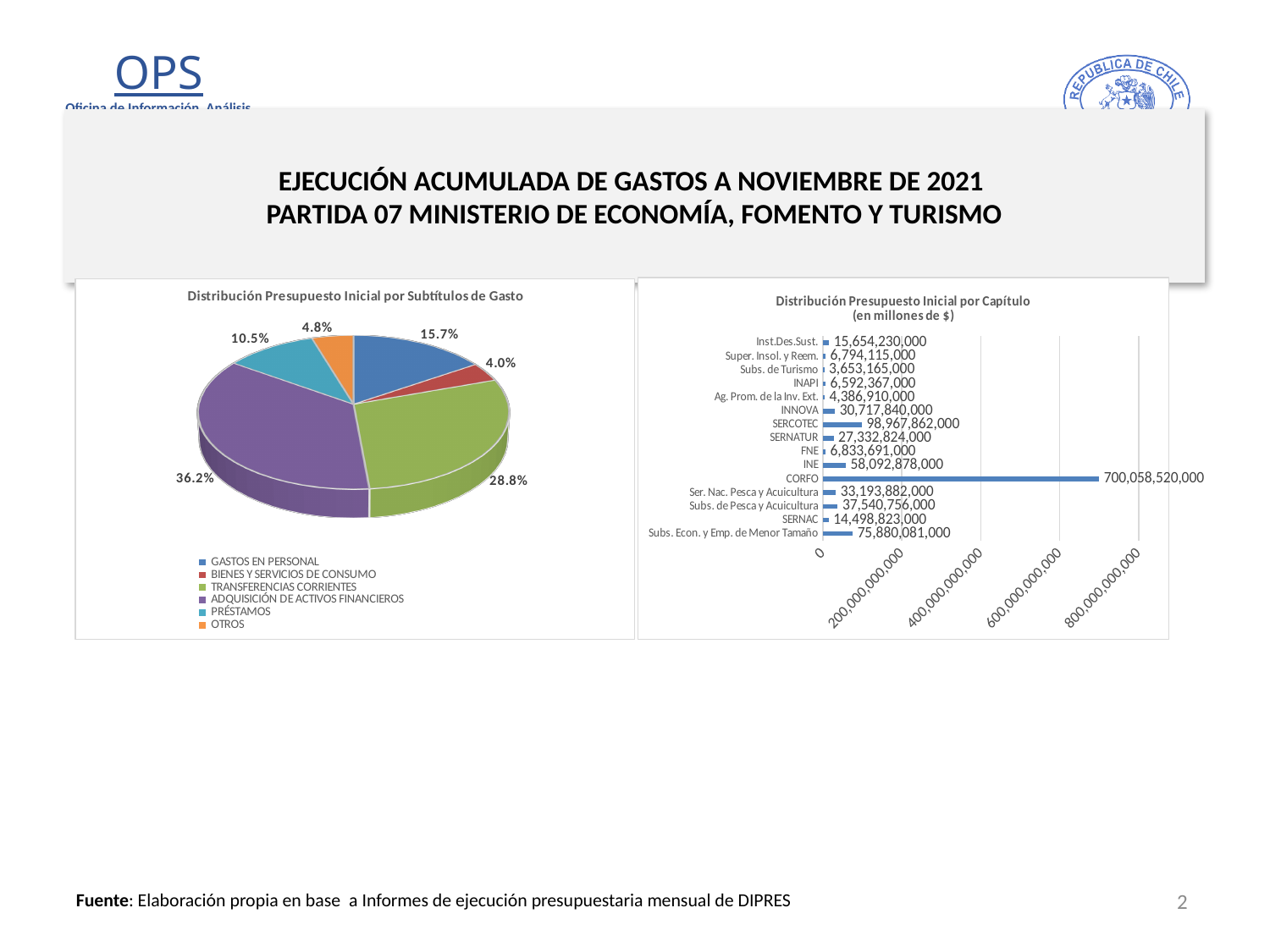
In the pie chart 'Distribución Presupuesto Inicial por Subtítulos de Gasto', what is the difference between the shares of TRANSFERENCIAS CORRIENTES and PRÉSTAMOS? 18.3% In the pie chart 'Distribución Presupuesto Inicial por Subtítulos de Gasto', what share does GASTOS EN PERSONAL have? 15.7% In the chart 'Distribución Presupuesto Inicial por Capítulo', which chapter has the lowest value? Subs. de Turismo What type of chart is 'Distribución Presupuesto Inicial por Capítulo'? Bar chart In the chart 'Distribución Presupuesto Inicial por Capítulo', what is the value for CORFO? 700,058,520,000 In the chart 'Distribución Presupuesto Inicial por Capítulo', how many chapters are plotted? 15 In the pie chart 'Distribución Presupuesto Inicial por Subtítulos de Gasto', which category has the smallest share? BIENES Y SERVICIOS DE CONSUMO In the pie chart 'Distribución Presupuesto Inicial por Subtítulos de Gasto', what share does ADQUISICIÓN DE ACTIVOS FINANCIEROS have? 36.2% In the chart 'Distribución Presupuesto Inicial por Capítulo', which is larger, INE or SERNATUR? INE In the chart 'Distribución Presupuesto Inicial por Capítulo', what is the value for SERCOTEC? 98,967,862,000 In the pie chart 'Distribución Presupuesto Inicial por Subtítulos de Gasto', how many categories does the legend list? 6 In the chart 'Distribución Presupuesto Inicial por Capítulo', what is the difference between the values for INNOVA and SERNATUR? 3,385,016,000